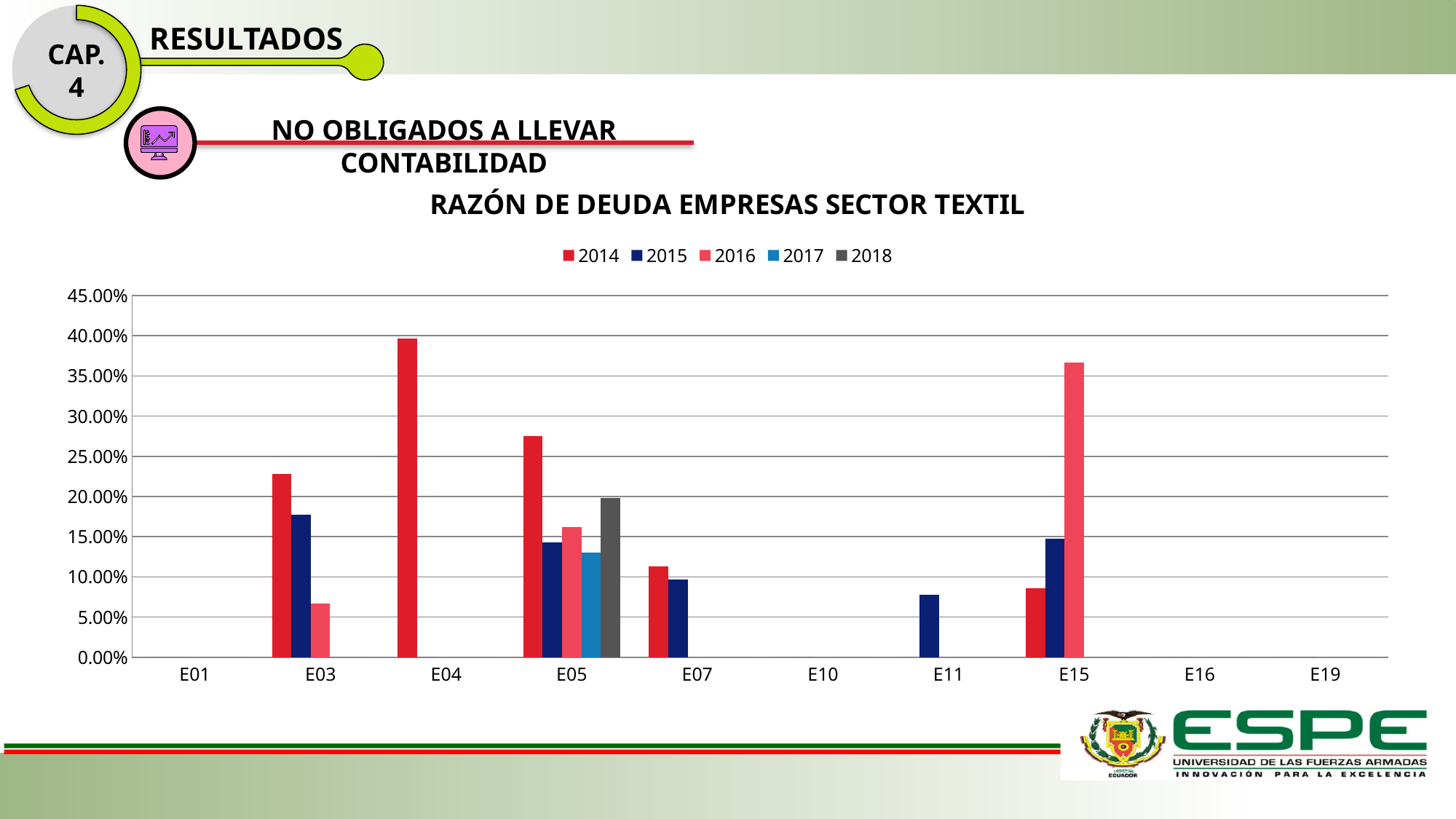
For E05, which is larger: the 2014 value or the 2018 value? 2014 What is the title of the chart? RAZÓN DE DEUDA EMPRESAS SECTOR TEXTIL Is the 2014 value for E04 greater or less than 35.00%? greater Is the 2016 value for E15 greater or less than 30.00%? greater How many categories are shown on the x axis of the chart? 10 Which is larger: the 2014 value for E03 or the 2016 value for E15? the 2016 value for E15 What kind of chart is shown on the slide? bar chart Is the 2015 value for E11 greater or less than 10.00%? less How many series does the legend of the chart list? 5 Within category E05, which series has the highest value? 2014 Which category has the highest value for the 2014 series? E04